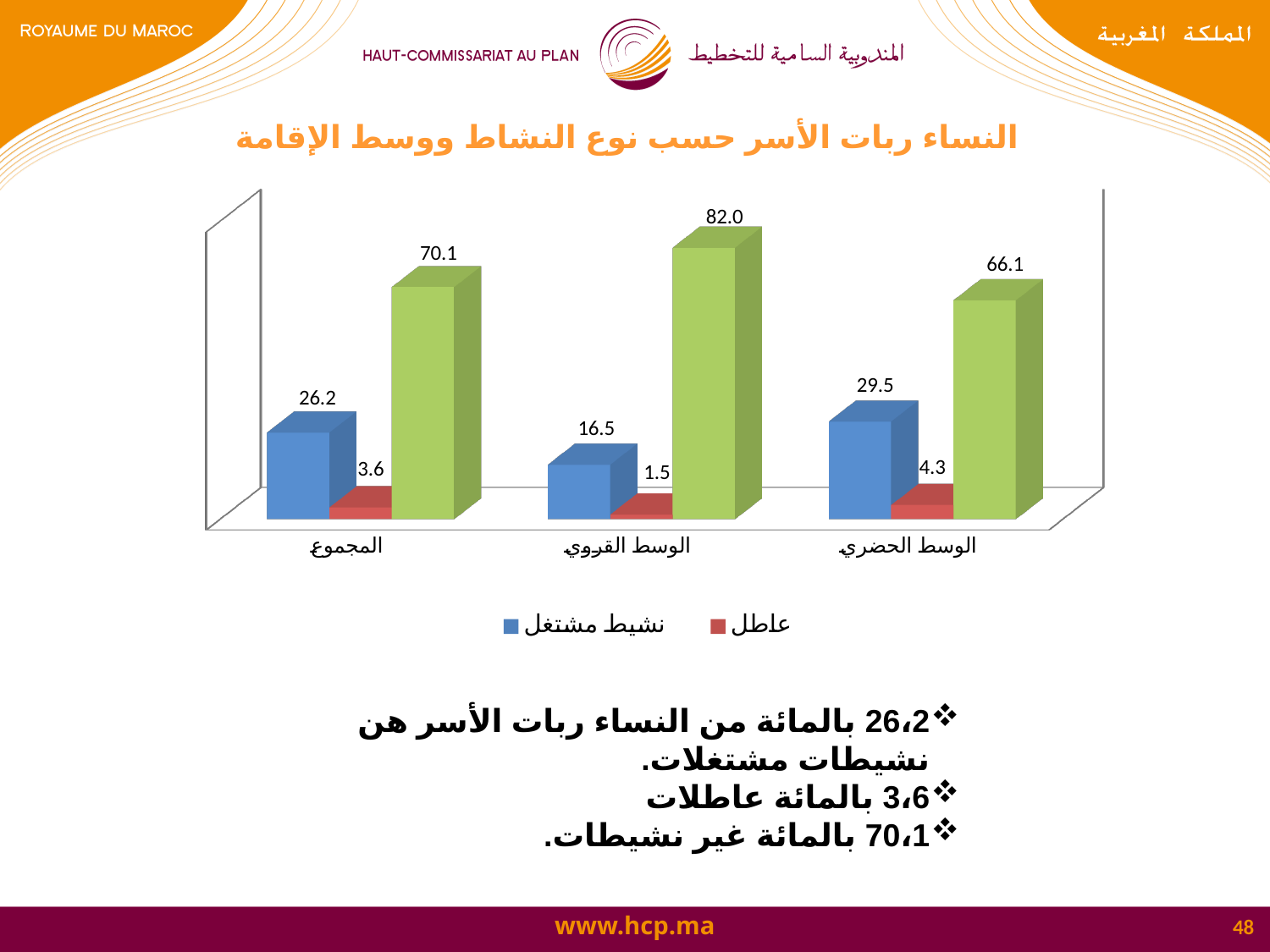
What colour are the bars for the عاطل series? red What is the value of نشيط مشتغل for المجموع? 26.2 How many series does the legend list? 2 What kind of chart is shown on the slide? bar chart How many categories are shown on the x axis? 3 What is the difference between the نشيط مشتغل values for الوسط الحضري and الوسط القروي? 13.0 What is the value of عاطل for الوسط القروي? 1.5 Which category has the highest value for the green series? الوسط القروي Which category has the lowest value for عاطل? الوسط القروي What is the value of the green series for الوسط الحضري? 66.1 Which is larger: the عاطل value for المجموع or for الوسط الحضري? الوسط الحضري What is the value of نشيط مشتغل for الوسط الحضري? 29.5